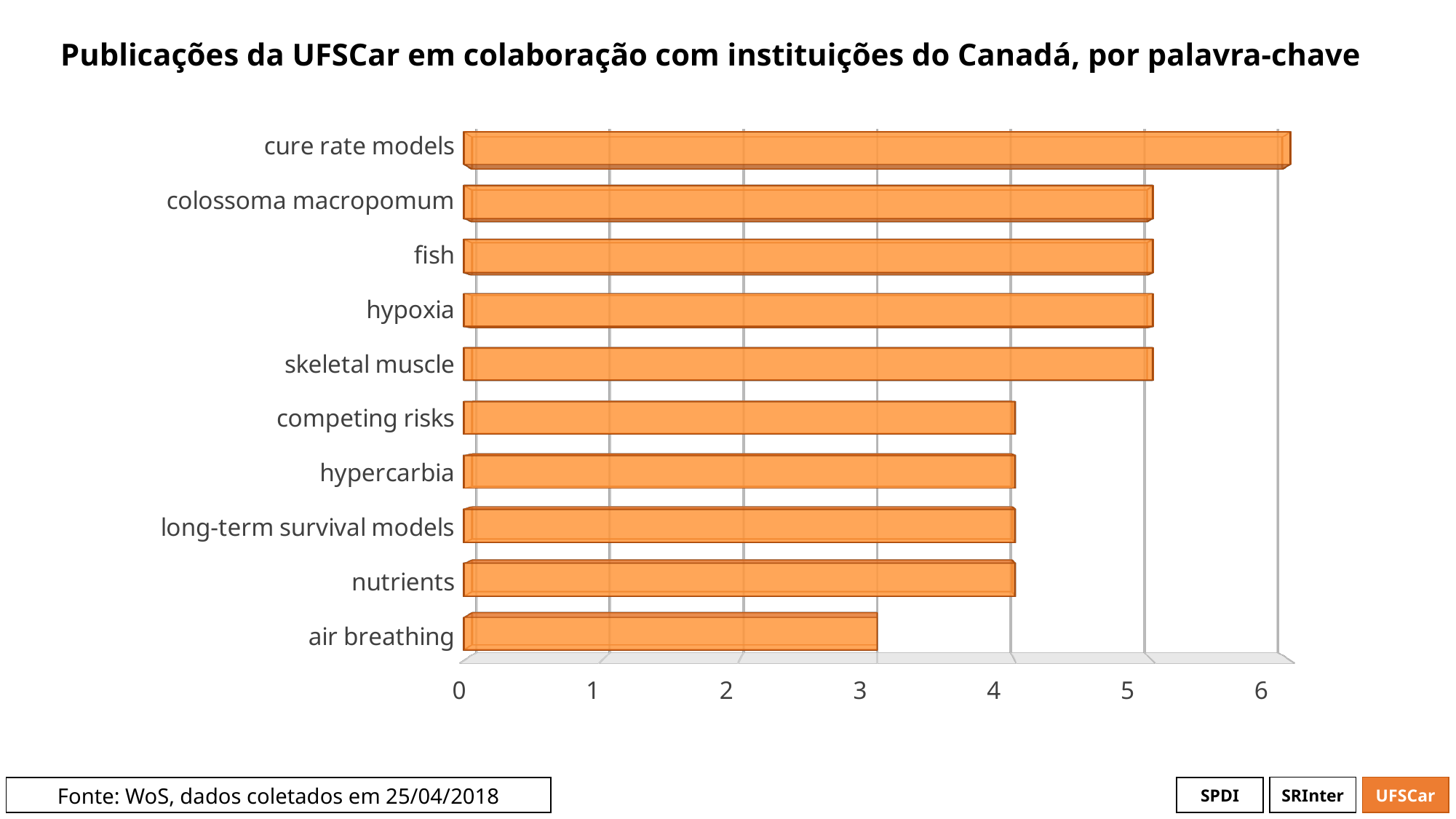
How many keywords (categories) are plotted in the chart? 10 Which is larger, the value for skeletal muscle or the value for hypercarbia? skeletal muscle Which keyword has the lowest number of publications? air breathing What is the value for cure rate models? 6 Is the value for hypoxia greater or less than 4? greater What is the value for fish? 5 Which keyword has the highest number of publications? cure rate models What is the value for competing risks? 4 Is the value for nutrients greater or less than 5? less What is the title of the chart? Publicações da UFSCar em colaboração com instituições do Canadá, por palavra-chave What is the value for air breathing? 3 What kind of chart is shown on the slide? bar chart